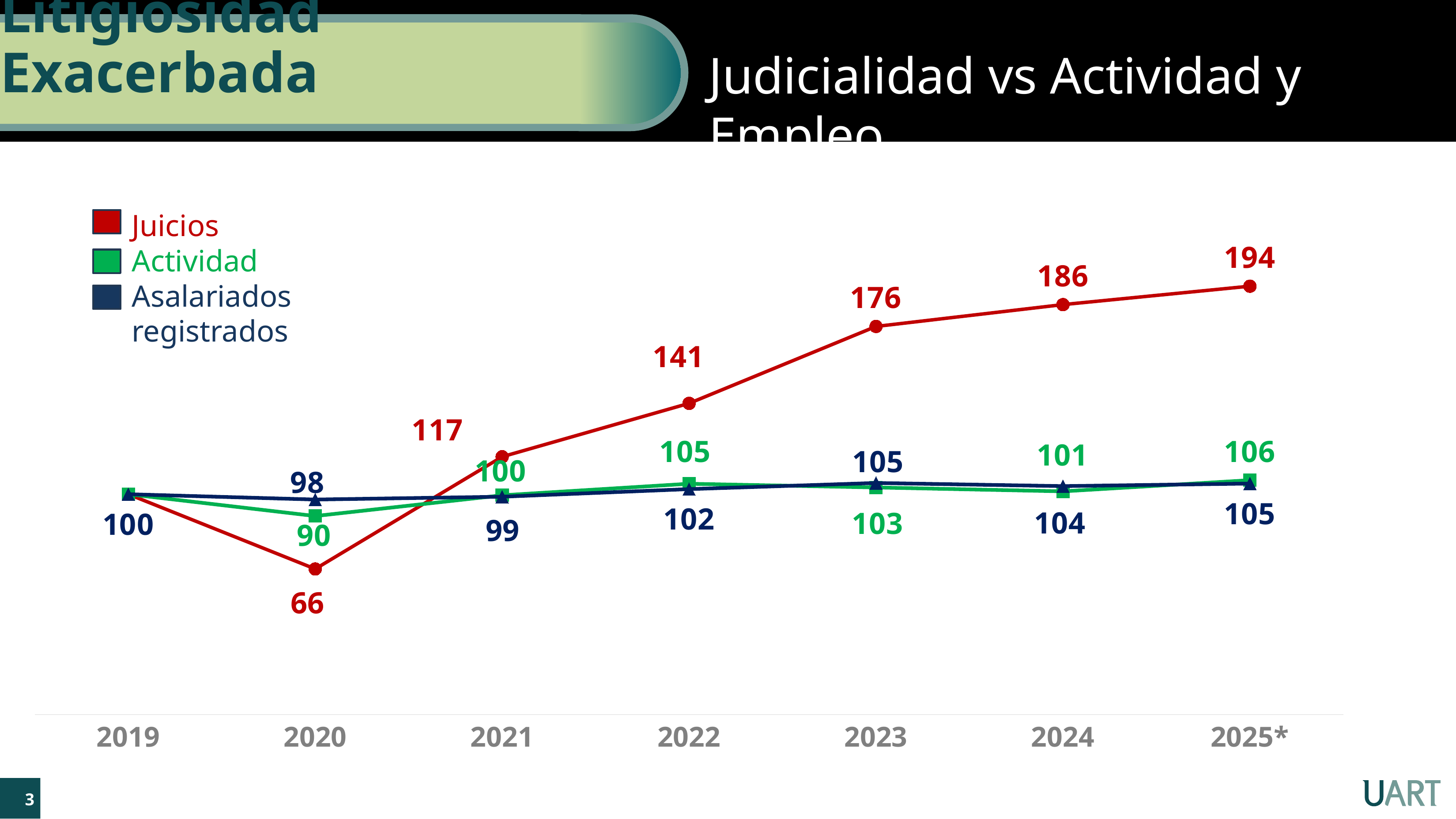
In which year does the Juicios series have its lowest value? 2020 What kind of chart is shown on the slide? Line chart In which year does the Juicios series reach its highest value? 2025* What is the difference between the Juicios values for 2025* and 2024? 8 What is the value of Actividad in 2022? 105 What is the value of Asalariados registrados in 2024? 104 In 2023, which series has the larger value, Juicios or Actividad? Juicios How many series does the legend list? 3 What is the value of Juicios in 2025*? 194 How many years are shown on the x axis? 7 What is the difference between the Juicios values for 2023 and 2022? 35 What is the value of Juicios in 2020? 66